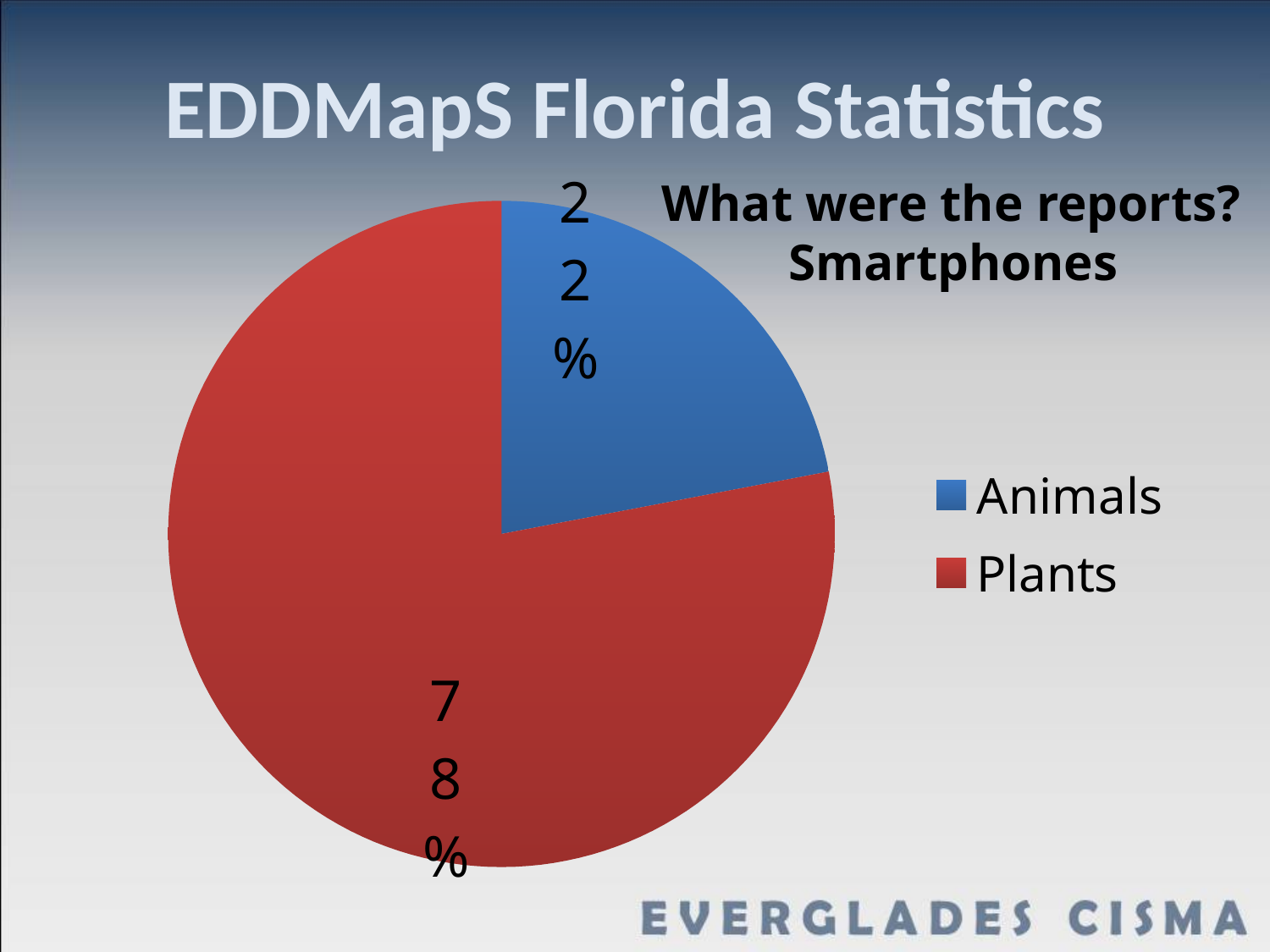
What percentage of the reports were Plants? 78% How many entries does the legend list? 2 What kind of chart is shown on the slide? pie chart Which is larger, the share for Plants or the share for Animals? Plants What is the title of the chart? What were the reports? Smartphones What is the difference in percentage points between Plants and Animals? 56 What colour is the Plants slice? red Which category has the smallest share of the pie? Animals Is the share for Plants greater or less than 50%? greater What percentage of the reports were Animals? 22% Which category has the largest share of the pie? Plants How many categories does the pie chart show? 2